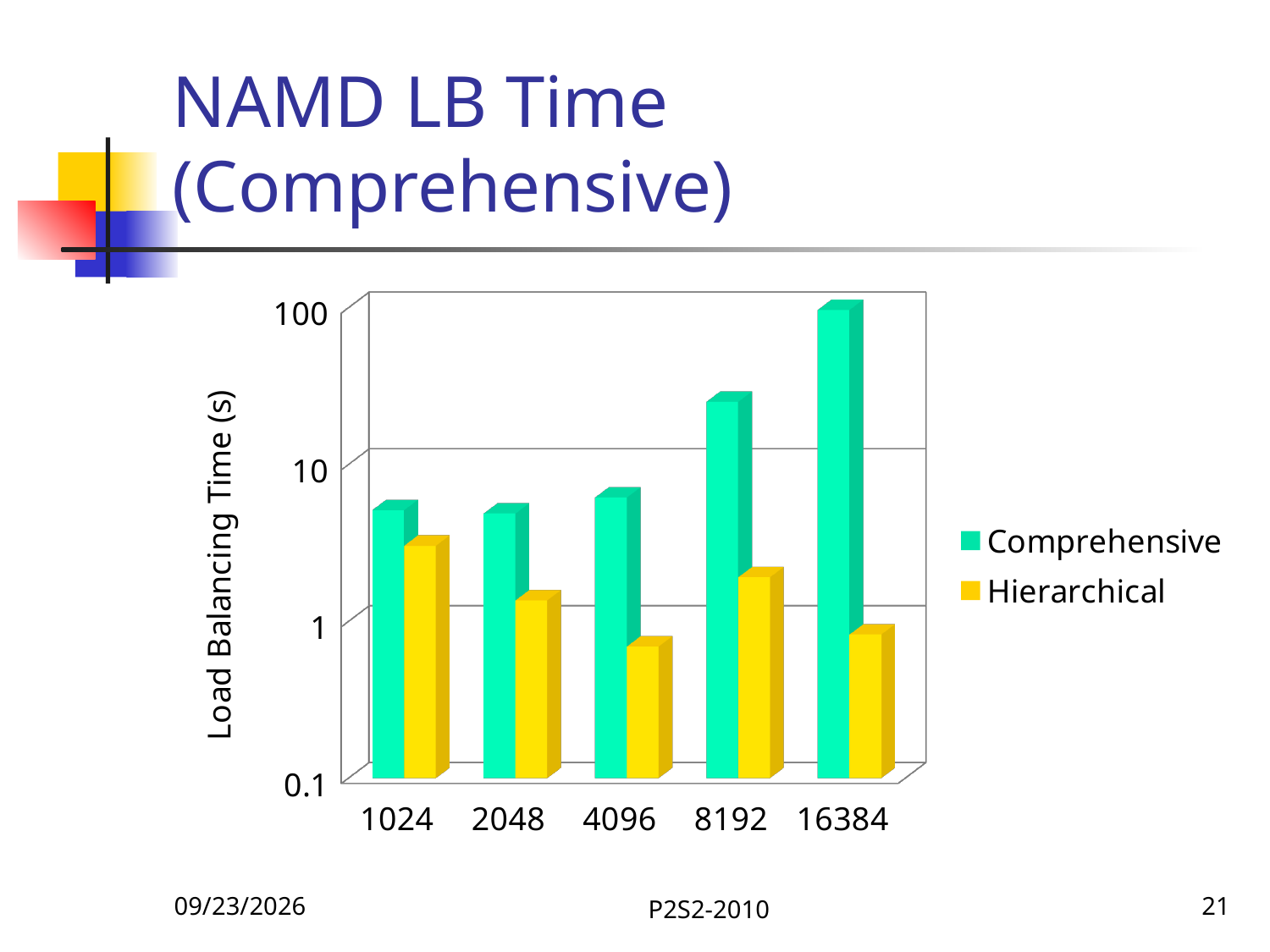
How many series does the legend list? 2 What is the label of the y axis? Load Balancing Time (s) At 16384, which series has the larger load balancing time, Comprehensive or Hierarchical? Comprehensive Is the Comprehensive value for 1024 greater or less than 10? less Does the Comprehensive load balancing time rise or fall from 4096 to 16384? rise How many processor-count categories are shown on the x axis? 5 Is the Comprehensive value for 16384 greater or less than 10? greater What kind of chart is shown on the slide? bar chart Is the Hierarchical value for 4096 greater or less than 1? less For which category is the Hierarchical load balancing time highest? 1024 For which category is the Comprehensive load balancing time highest? 16384 Which series is shown in yellow in the legend? Hierarchical